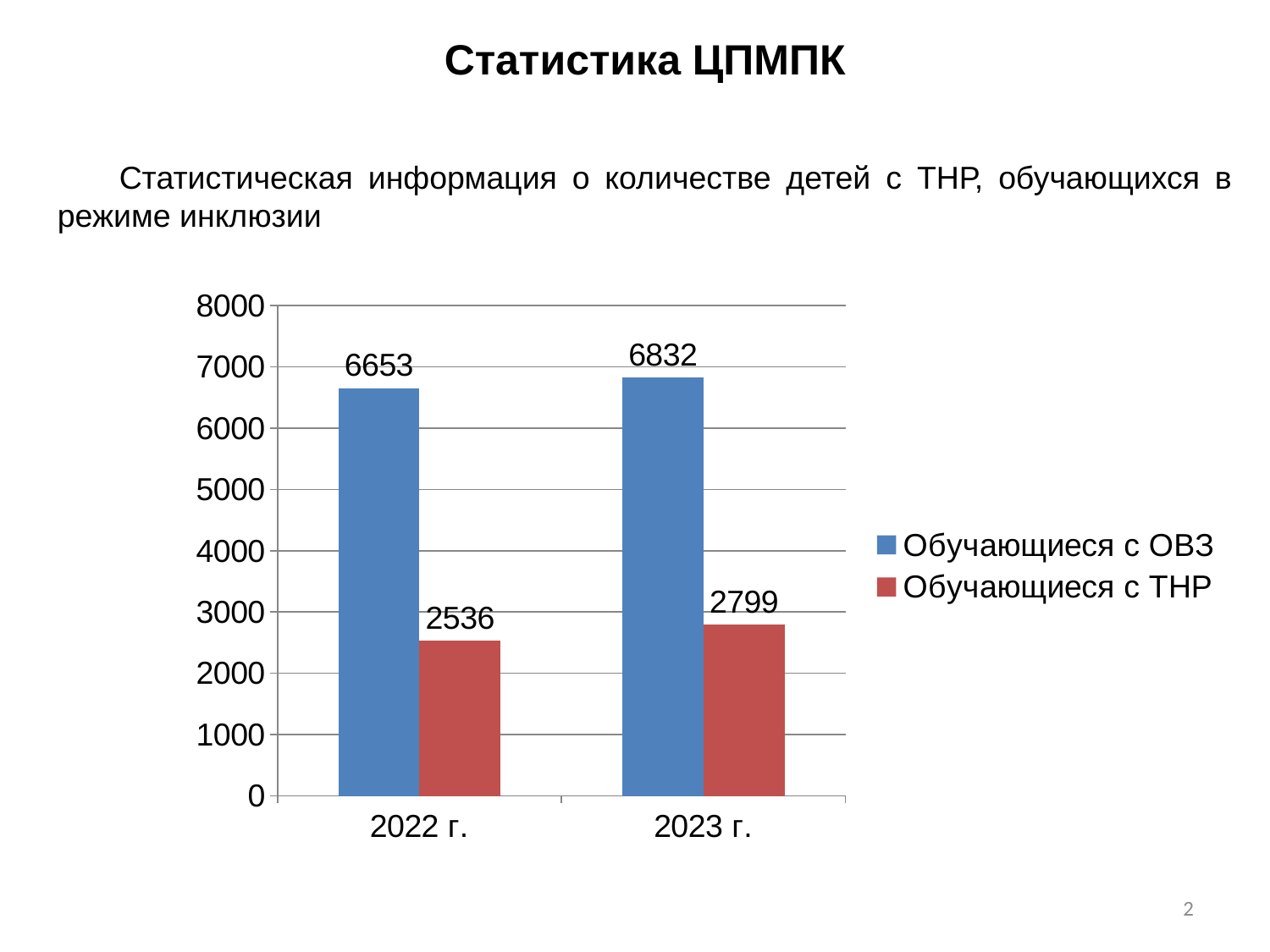
In which year is the value for Обучающиеся с ТНР lowest? 2022 г. What kind of chart is shown on the slide? bar chart How many years are shown on the x axis? 2 In which year is the value for Обучающиеся с ОВЗ highest? 2023 г. What is the value for Обучающиеся с ОВЗ in 2022 г.? 6653 How many series does the legend list? 2 What is the difference between Обучающиеся с ОВЗ in 2023 г. and in 2022 г.? 179 Is the value for Обучающиеся с ТНР in 2023 г. greater or less than 3000? less What is the value for Обучающиеся с ТНР in 2022 г.? 2536 What is the value for Обучающиеся с ТНР in 2023 г.? 2799 Which is larger in 2023 г.: Обучающиеся с ОВЗ or Обучающиеся с ТНР? Обучающиеся с ОВЗ What is the difference between Обучающиеся с ОВЗ and Обучающиеся с ТНР in 2022 г.? 4117